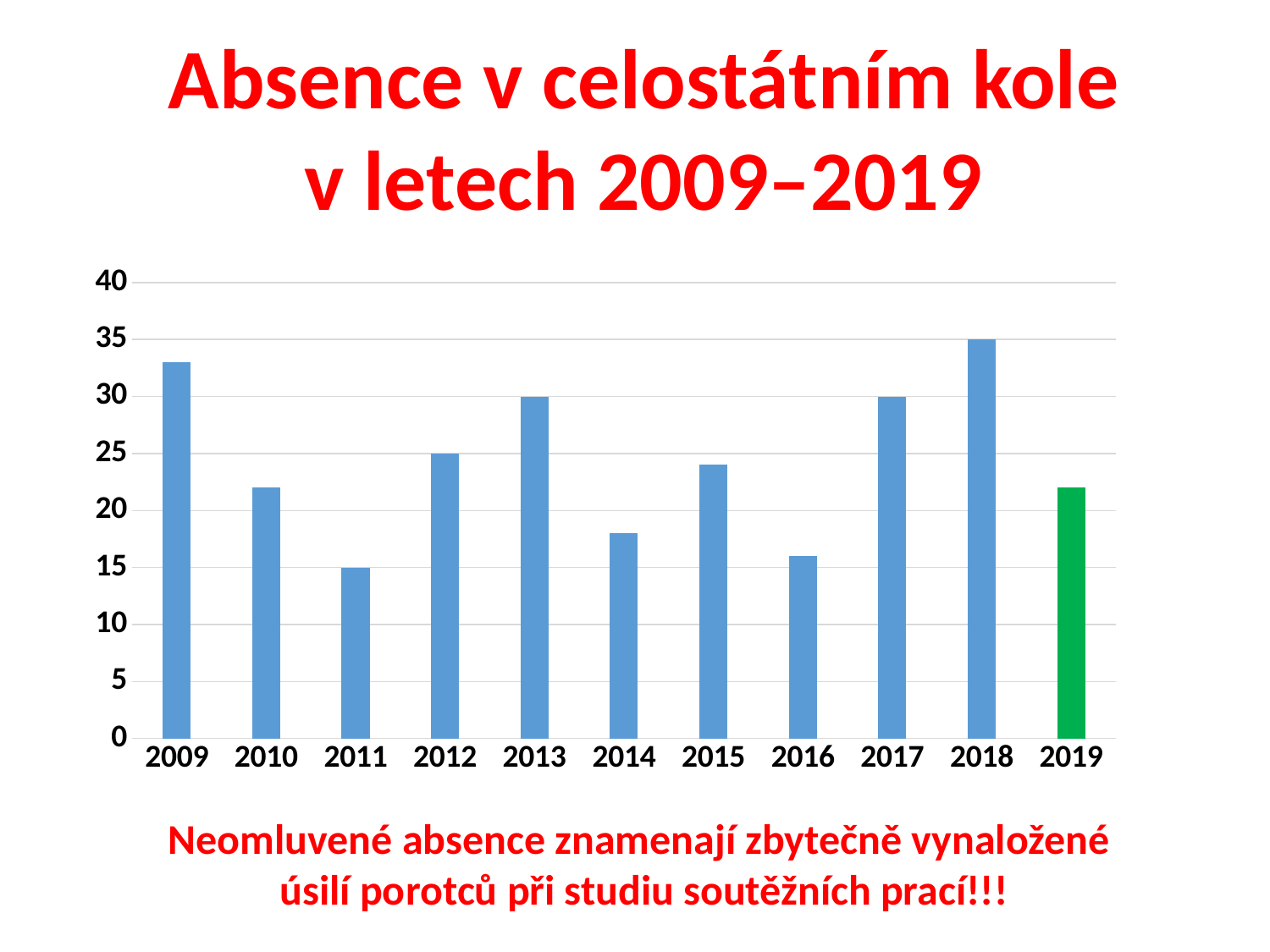
Which bar in the chart is coloured green? 2019 What is the value for 2018? 35 What is the value for 2013? 30 What is the value for 2011? 15 What is the difference between the values for 2018 and 2017? 5 Which year has the larger value, 2009 or 2010? 2009 Which year has the highest number of absences in the chart? 2018 Is the value for 2014 greater or less than 20? less What type of chart is shown on the slide? bar chart Is the value for 2009 greater or less than 30? greater What is the value for 2012? 25 How many years are shown on the x axis of the chart? 11